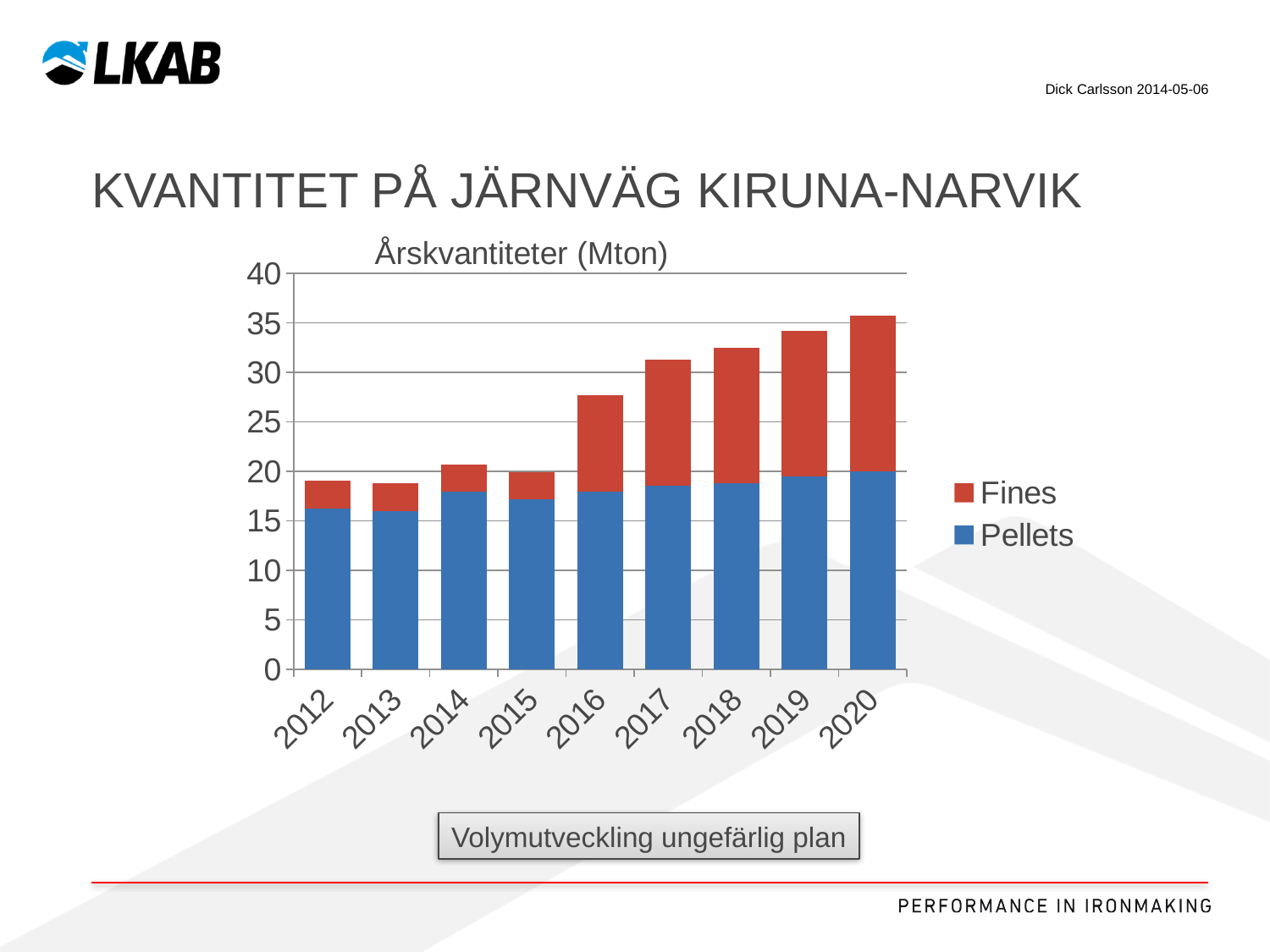
Which year has the larger total bar, 2014 or 2017? 2017 How many series does the chart legend list? 2 How many years are shown on the x axis of the chart? 9 What is the title of the chart? Årskvantiteter (Mton) Is the total value for 2019 greater or less than 30? greater Is the total value for 2012 greater or less than 20? less Is the Pellets value for 2020 greater or less than 15? greater Which colour represents Fines in the chart? red What kind of chart is shown on the slide? stacked bar chart Do the total annual quantities generally rise or fall from 2012 to 2020? rise Which year has the highest total stacked bar? 2020